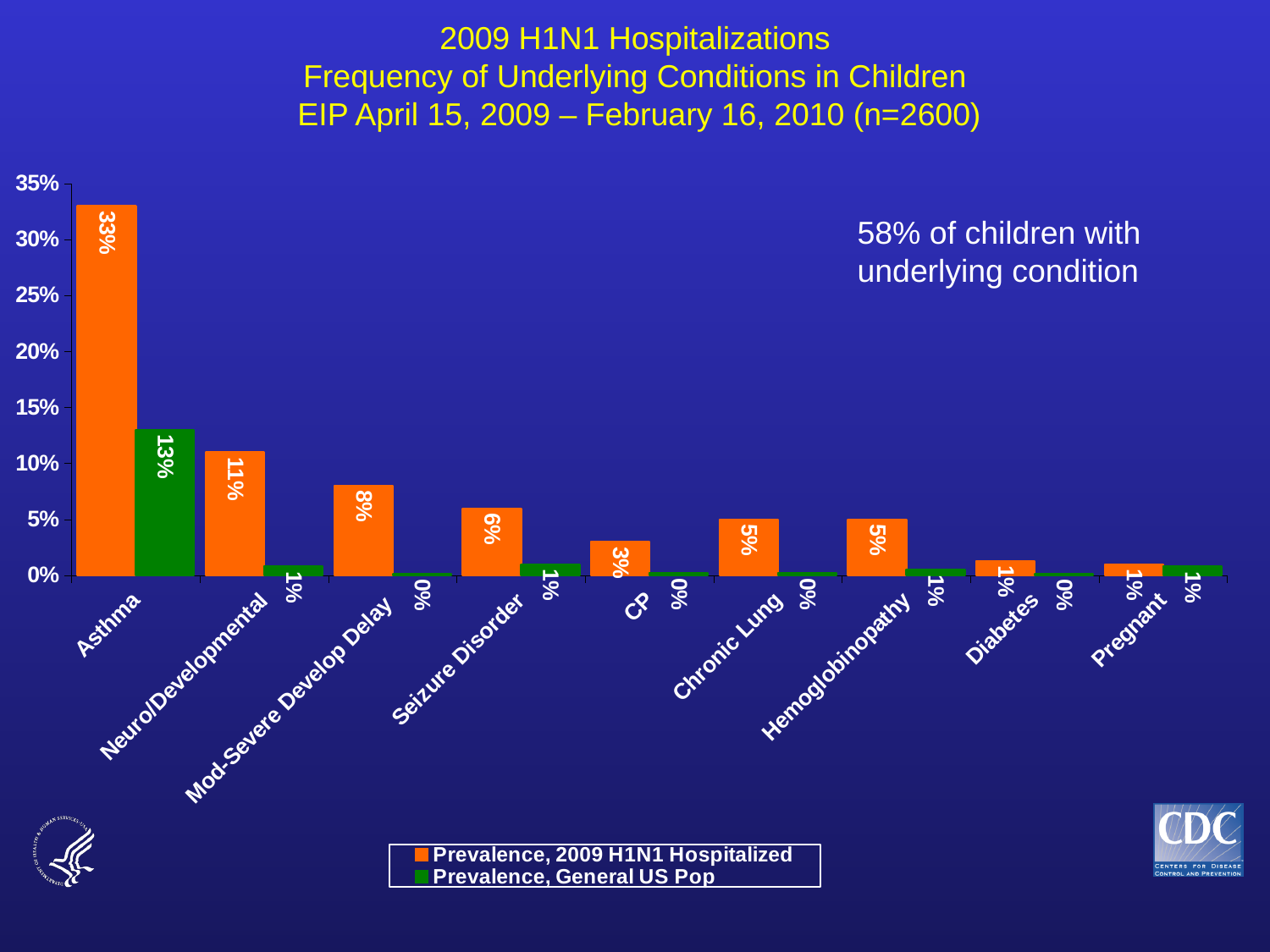
How many series does the legend list? 2 What type of chart is shown on the slide? bar chart What is the prevalence of Neuro/Developmental conditions among 2009 H1N1 hospitalized children? 11% Which underlying condition has the highest prevalence among 2009 H1N1 hospitalized children? Asthma What is the prevalence of asthma in the general US population? 13% What is the difference between the prevalence of asthma among 2009 H1N1 hospitalized children and in the general US population? 20% What is the prevalence of asthma among 2009 H1N1 hospitalized children? 33% Is the prevalence of asthma among 2009 H1N1 hospitalized children greater or less than 30%? greater How many underlying condition categories are shown on the x axis? 9 Which is larger: the prevalence of Mod-Severe Develop Delay or Seizure Disorder among 2009 H1N1 hospitalized children? Mod-Severe Develop Delay What colour represents the Prevalence, General US Pop series? green What is the prevalence of Seizure Disorder in the general US population? 1%